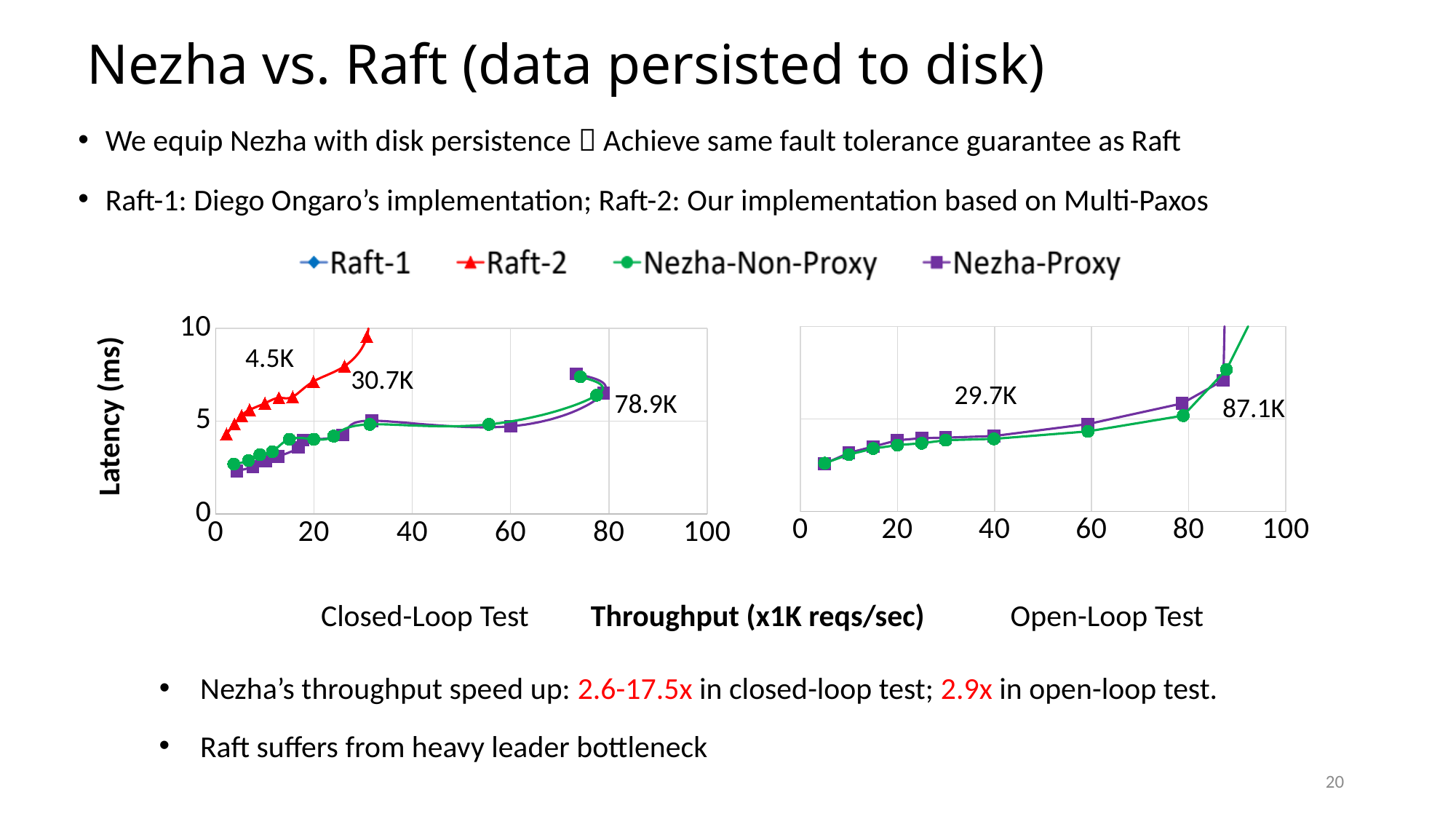
In the Closed-Loop Test chart, what throughput value is annotated at the far right of the Nezha curves? 78.9K How many series does the legend list? 4 In the Open-Loop Test chart, what is the larger of the two throughput annotations? 87.1K In the Open-Loop Test chart, what is the difference between the two throughput annotations 87.1K and 29.7K? 57.4K How many charts are shown on the slide? 2 What are the series names listed in the legend? Raft-1, Raft-2, Nezha-Non-Proxy, Nezha-Proxy What kind of chart is the Closed-Loop Test chart? line chart In the Closed-Loop Test chart, is the highest latency plotted for Raft-2 greater or less than 5? greater What is the label on the y axis of the charts? Latency (ms) In the Closed-Loop Test chart, at a throughput of 20, which series has the higher latency: Raft-2 or Nezha-Non-Proxy? Raft-2 In the Open-Loop Test chart, is the latency of Nezha-Non-Proxy at a throughput of 60 greater or less than 5? less In the Closed-Loop Test chart, what throughput value is annotated at the end of the Raft-2 curve? 30.7K